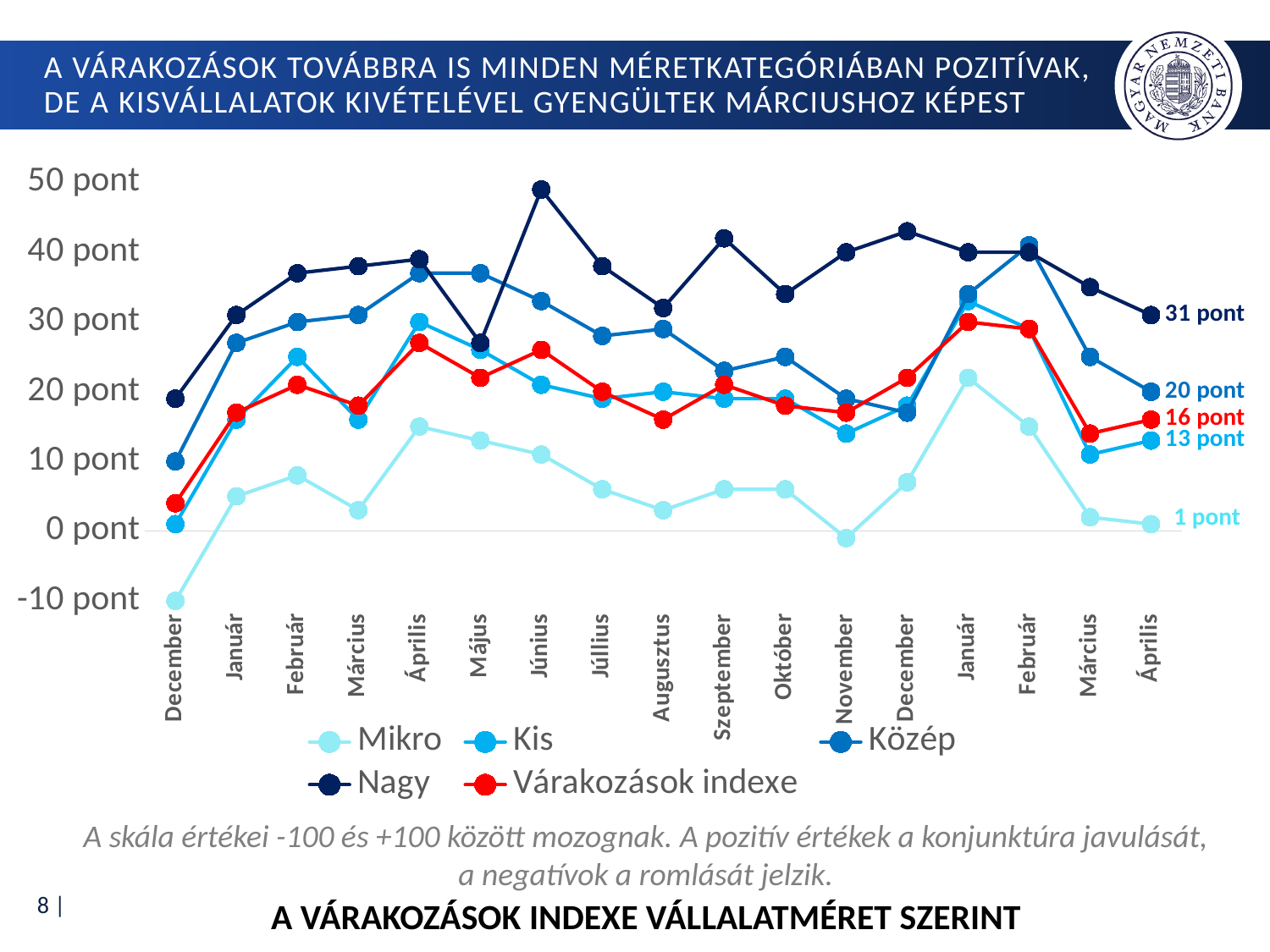
Is the value of the Nagy series in Június greater or less than 40 pont? greater Does the Mikro series rise or fall from the second Január to the final Április? Fall What is the value of the Nagy series at the final Április point? 31 pont At the final Április point, what is the difference between the Nagy and Közép values? 11 pont At the final Április point, which is larger: the Kis value or the Közép value? Közép What is the value of the Közép series at the final Április point? 20 pont How many series does the legend list? 5 Which series has the lowest value at the final Április point? Mikro What is the value of the Várakozások indexe series at the final Április point? 16 pont What kind of chart is shown on the slide? Line chart Which series has the highest value at the final Április point? Nagy What is the value of the Mikro series at the final Április point? 1 pont